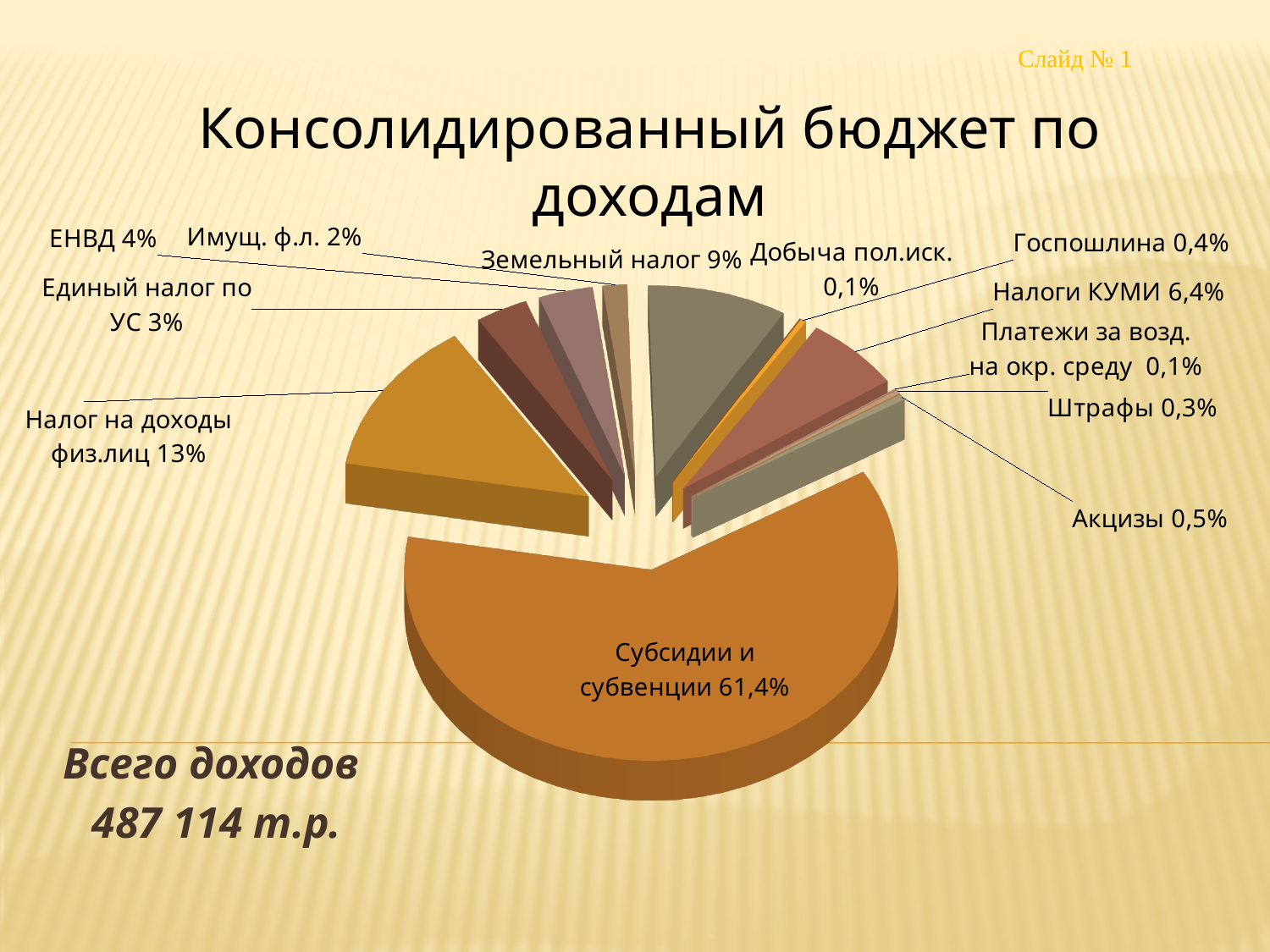
What percentage is shown for Акцизы? 0,5% What is the difference in percentage points between Налог на доходы физ.лиц and Земельный налог? 4 What is the difference in percentage points between Субсидии и субвенции and Налог на доходы физ.лиц? 48,4 Which is larger: the share for ЕНВД or the share for Единый налог по УС? ЕНВД Which category has the largest share of the pie? Субсидии и субвенции What share of the consolidated budget revenue comes from Субсидии и субвенции? 61,4% What type of chart is shown on the slide? pie chart How many slices does the pie chart have? 12 What percentage is shown for Налоги КУМИ? 6,4% What percentage is shown for Земельный налог? 9% What percentage is shown for Налог на доходы физ.лиц? 13% What total revenue amount is stated on the slide? 487 114 т.р.